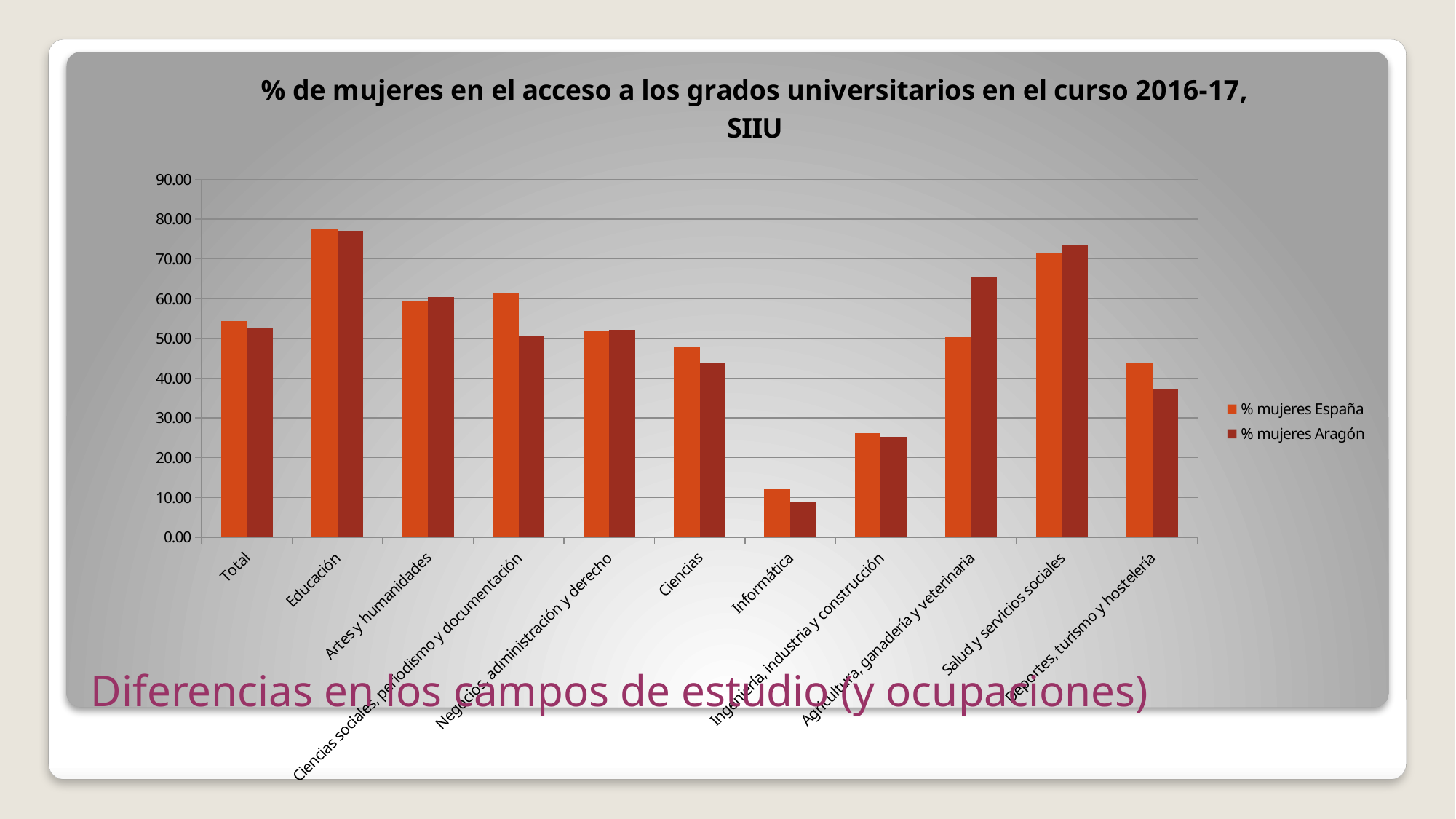
Is the value for % mujeres España in Educación greater or less than 70.00? greater Which category has the highest value for % mujeres España? Educación What kind of chart is shown on the slide? bar chart Which category has the lowest value for % mujeres Aragón? Informática Is the value for % mujeres España in Total greater or less than 50.00? greater Which category has the lowest value for % mujeres España? Informática For Agricultura, ganadería y veterinaria, which series has the larger value: % mujeres España or % mujeres Aragón? % mujeres Aragón How many series does the legend list? 2 For Deportes, turismo y hostelería, which series has the larger value: % mujeres España or % mujeres Aragón? % mujeres España How many categories are shown on the x axis? 11 Is the value for % mujeres Aragón in Agricultura, ganadería y veterinaria greater or less than 60.00? greater What is the title of the chart? % de mujeres en el acceso a los grados universitarios en el curso 2016-17, SIIU